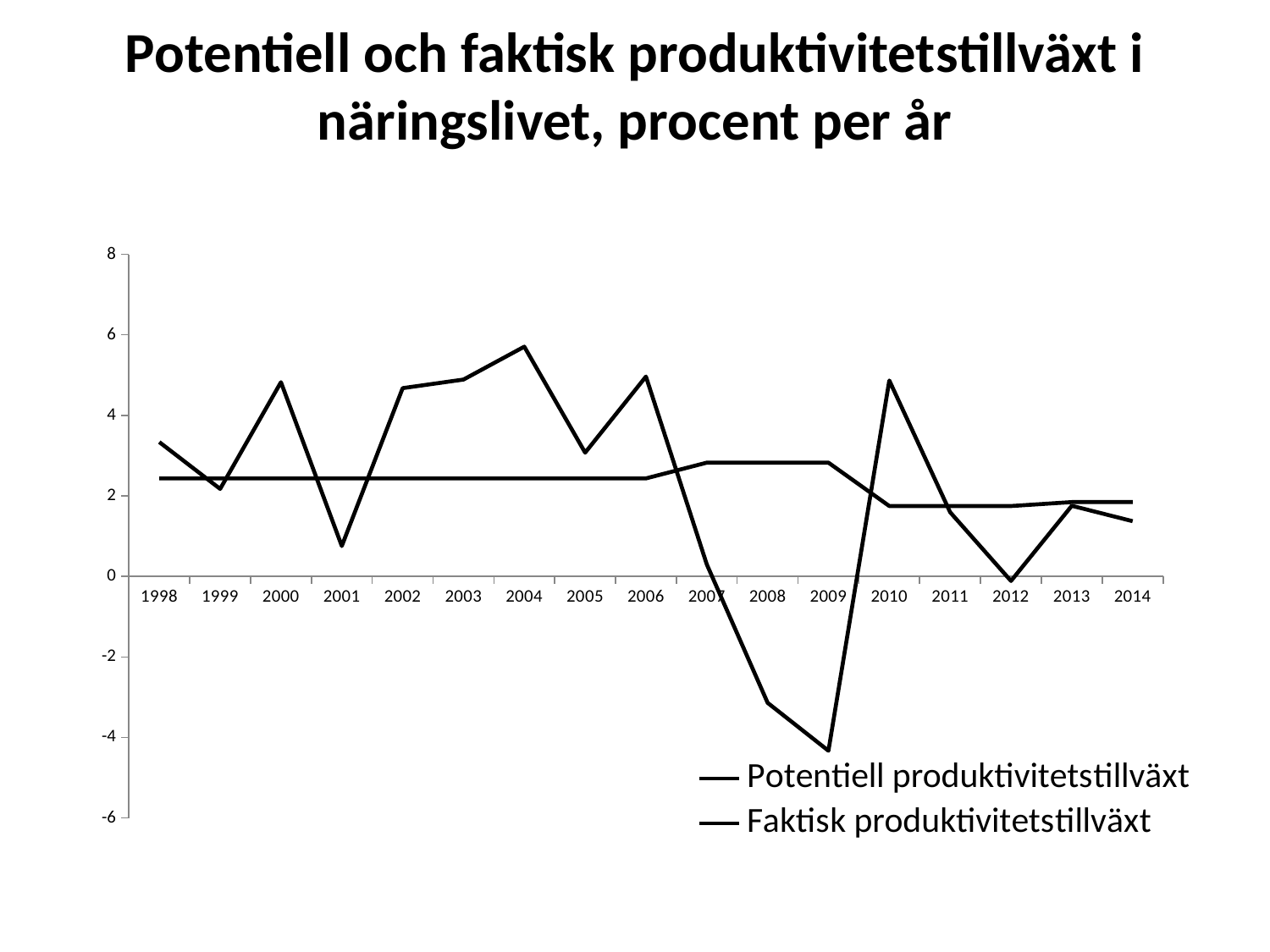
In which year does the chart reach its highest plotted value? 2004 Is the lowest value plotted in 2001 greater or less than 2? less Is the highest value plotted in 2004 greater or less than 4? greater What is the title of the chart? Potentiell och faktisk produktivitetstillväxt i näringslivet, procent per år In which year does the chart reach its lowest plotted value? 2009 What are the two entries in the legend? Potentiell produktivitetstillväxt and Faktisk produktivitetstillväxt Is the lowest value plotted in 2009 greater or less than -4? less What is the first year shown on the x axis? 1998 What kind of chart is shown on the slide? line chart What is the last year shown on the x axis? 2014 How many years are shown along the x axis? 17 How many series does the legend list? 2